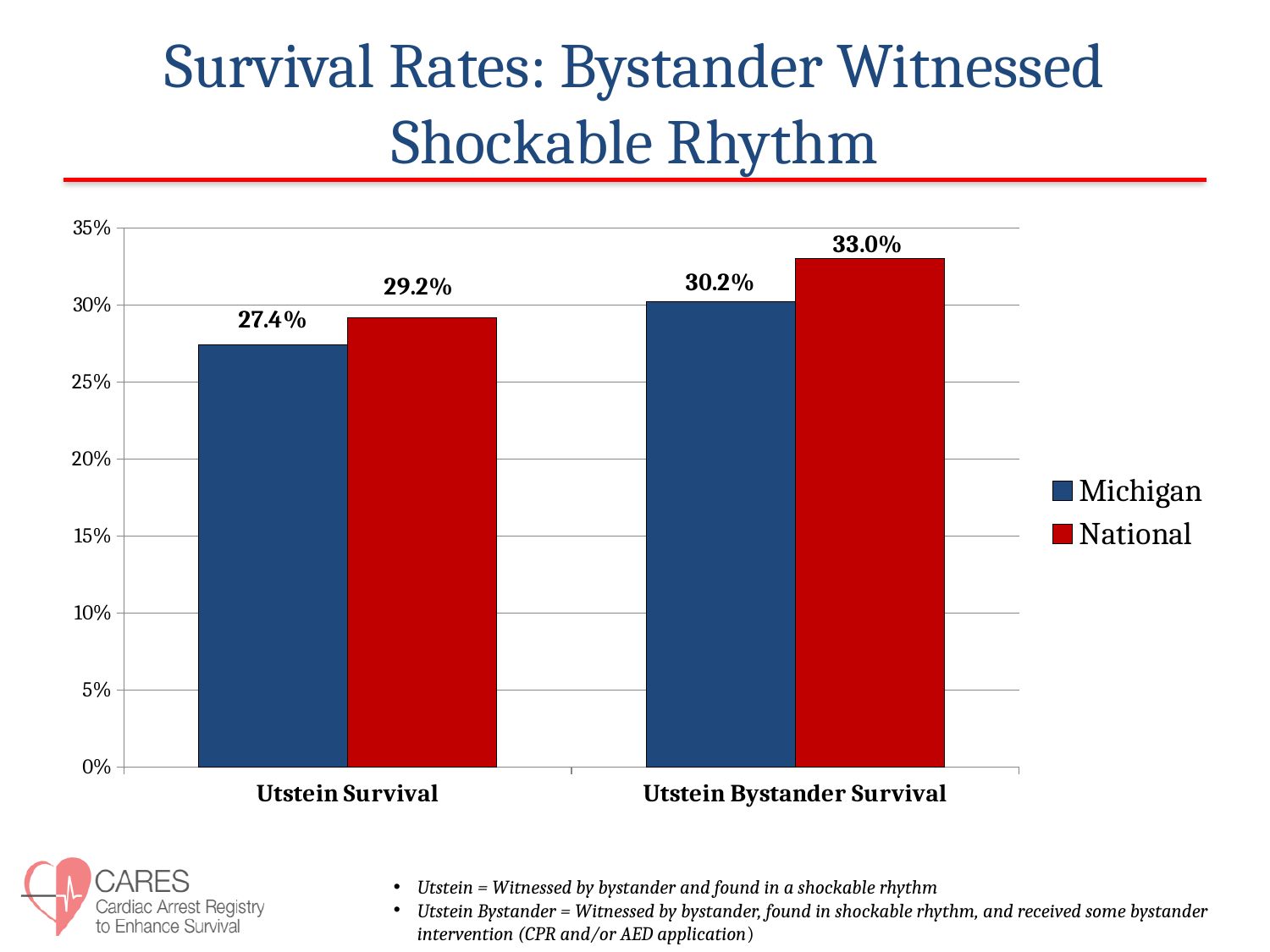
How many series does the legend list? 2 What kind of chart is shown on the slide? Bar chart What colour represents the National series? Red What is the difference between the National and Michigan values for Utstein Bystander Survival? 2.8% Which bar has the lowest value on the chart? Michigan, Utstein Survival What is the Michigan value for Utstein Survival? 27.4% What is the National value for Utstein Bystander Survival? 33.0% What is the Michigan value for Utstein Bystander Survival? 30.2% What is the difference between the National and Michigan values for Utstein Survival? 1.8% Which is larger for Utstein Survival, Michigan or National? National What is the National value for Utstein Survival? 29.2% Which bar has the highest value on the chart? National, Utstein Bystander Survival